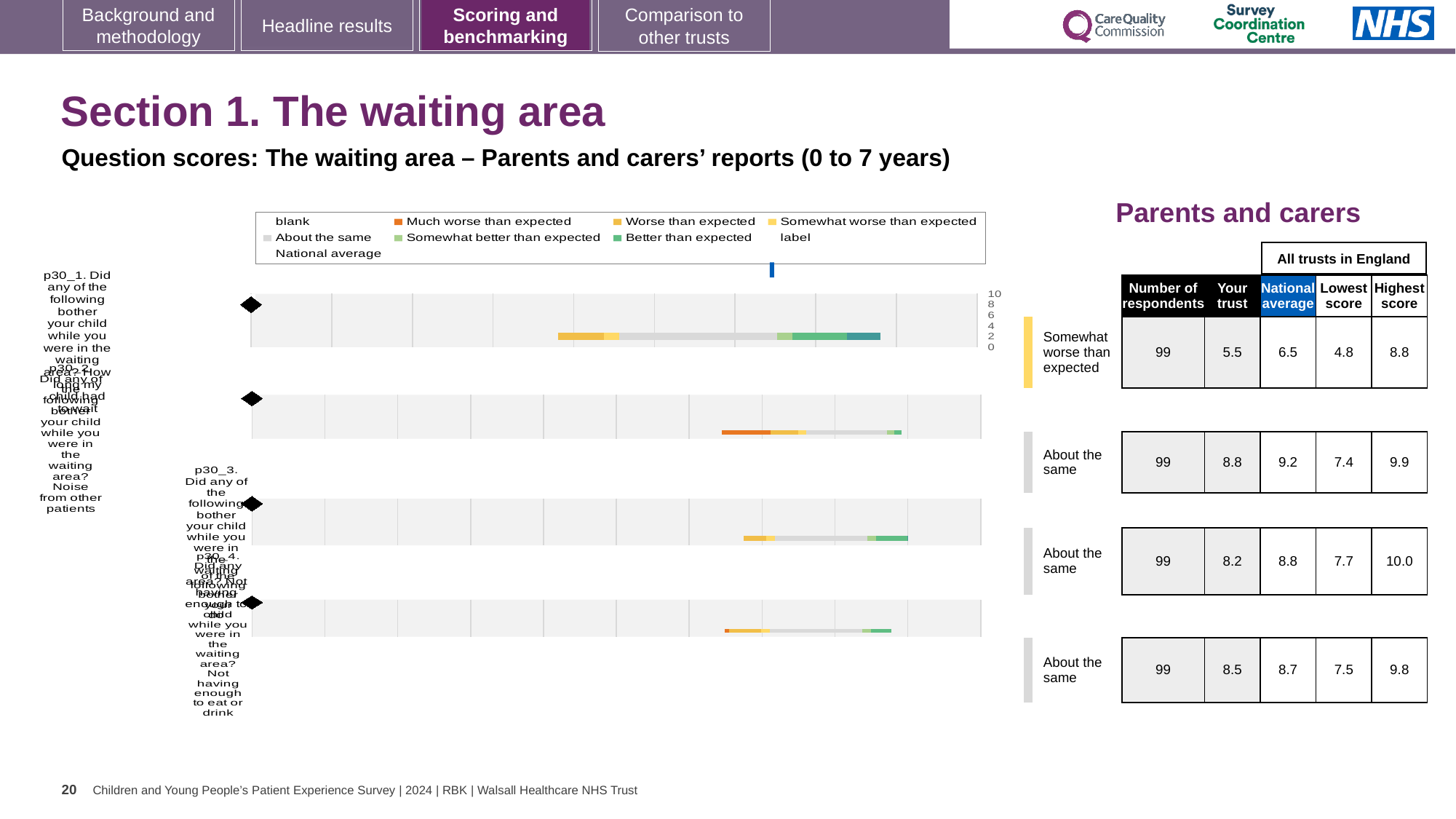
In the table beside the chart, what is the lowest score for the fourth question (p30_4, not having enough to eat or drink)? 7.5 How many question bars are plotted in the chart? 4 How many respondents are listed for each question in the table beside the chart? 99 How many entries does the chart legend list? 9 What colour does the legend use for 'Much worse than expected'? orange What is the highest value shown on the chart's axis? 10 Which benchmark category is the first question (p30_1) rated as in the table beside the chart? Somewhat worse than expected In the table beside the chart, what is the national average for the first question (p30_1)? 6.5 In the table beside the chart, what is the highest score for the third question (p30_3, noise from other patients)? 10.0 In the table beside the chart, is the 'Your trust' score for the second question (p30_2) larger or smaller than its national average? smaller What kind of chart is shown on the slide? bar chart In the table beside the chart, what is the 'Your trust' score for the first question (p30_1, waiting area – long wait)? 5.5